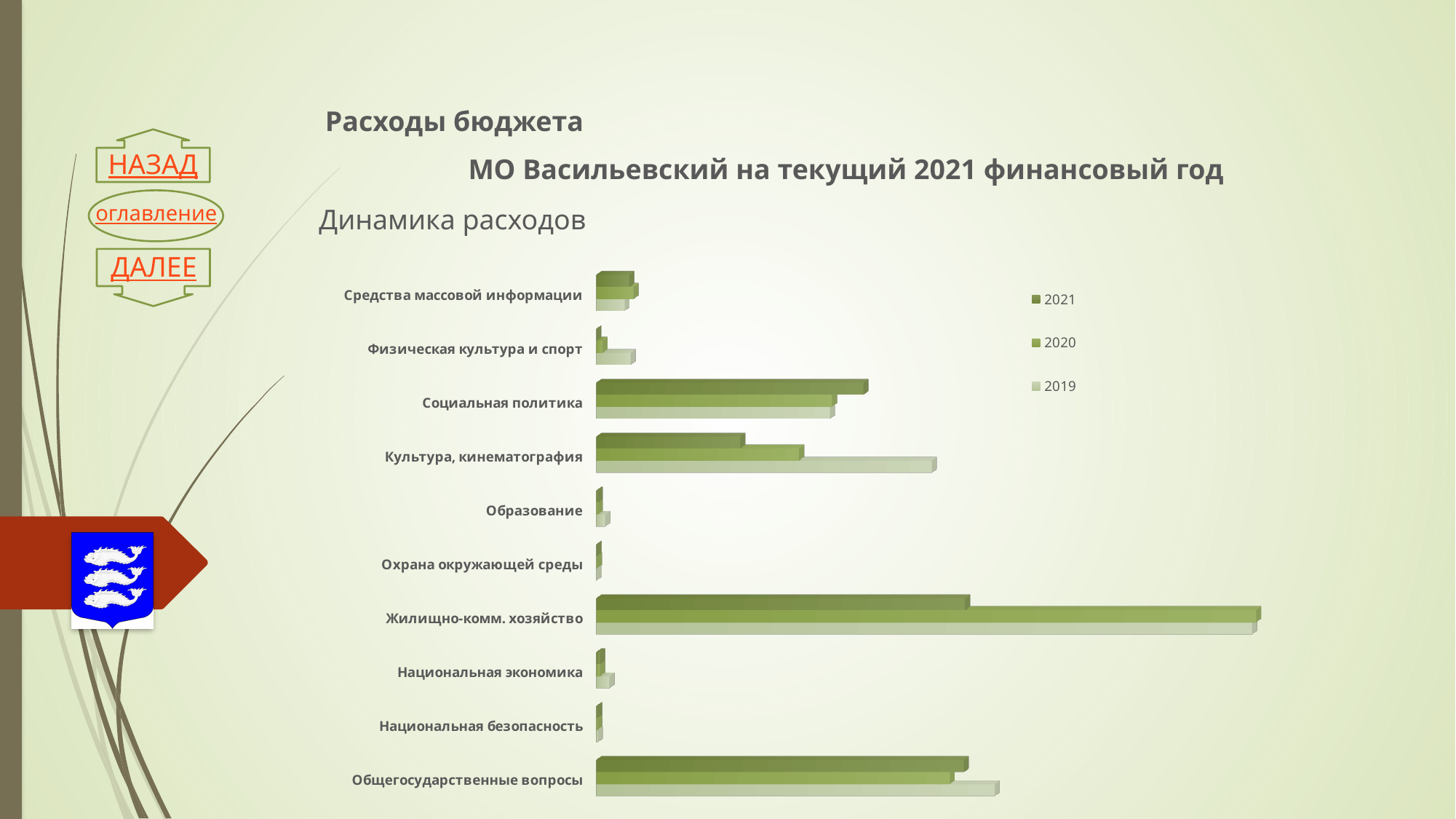
For Культура, кинематография, do the values rise or fall from 2019 to 2021? Fall For Культура, кинематография, which year has the larger value: 2019 or 2021? 2019 How many expenditure categories are shown on the chart? 10 Which years are listed in the chart legend? 2021, 2020, 2019 Which category has the highest value for 2019? Жилищно-комм. хозяйство How many series does the chart legend list? 3 For 2021, which is larger: Социальная политика or Культура, кинематография? Социальная политика What is the title of the chart? Динамика расходов What kind of chart is shown on the slide? Bar chart For 2021, which is larger: Средства массовой информации or Физическая культура и спорт? Средства массовой информации